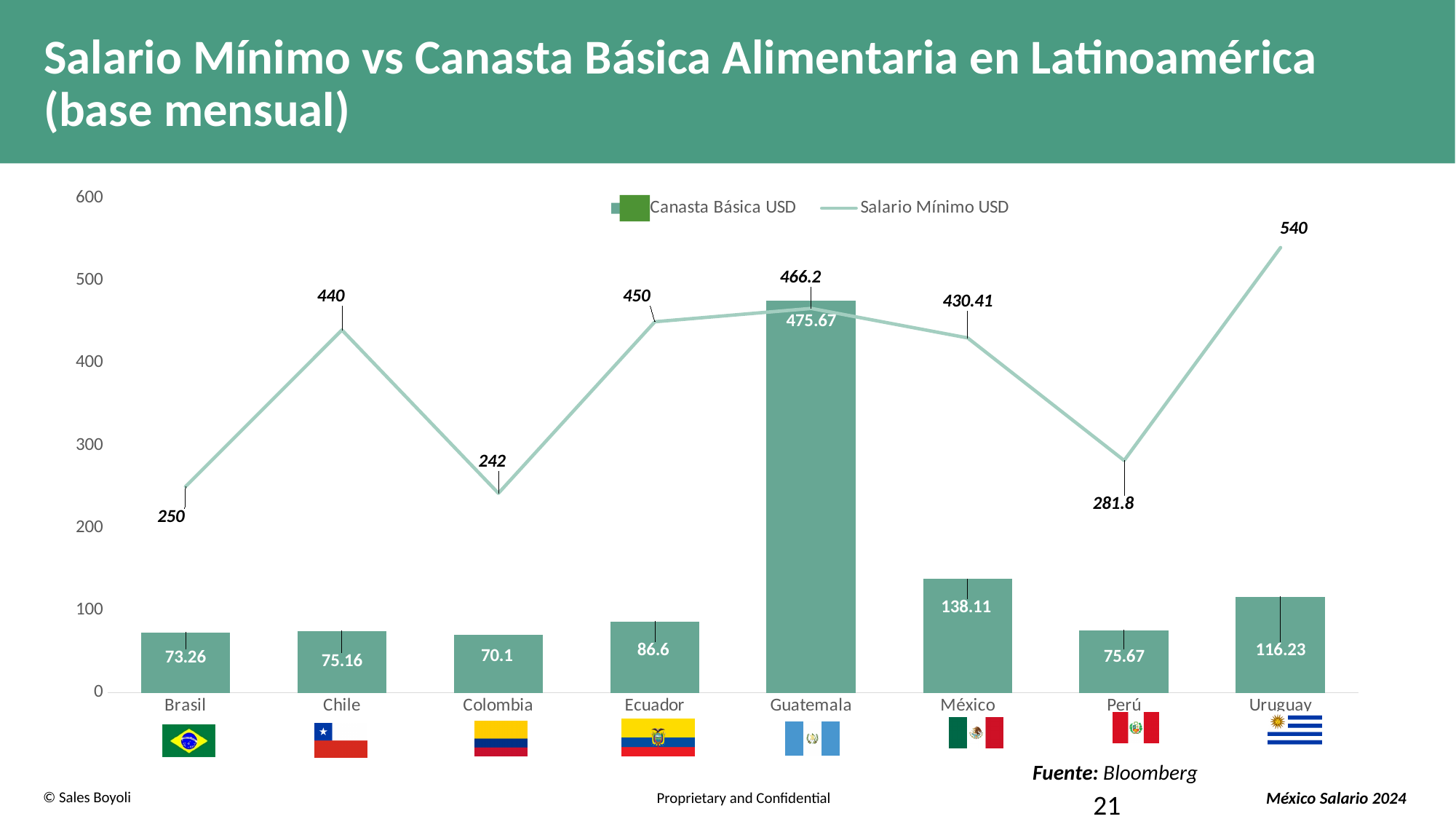
Which country has the highest Salario Mínimo USD? Uruguay What kind of chart is this? Combined bar and line chart Is the Salario Mínimo USD for Perú greater or less than 300? less How many series does the legend list? 2 How many countries are shown on the x axis? 8 What is the difference between the Salario Mínimo USD for Chile and for Brasil? 190 What is the Canasta Básica USD value for México? 138.11 What is the Salario Mínimo USD value for Uruguay? 540 Which country has the lowest Salario Mínimo USD? Colombia Which country has the lowest Canasta Básica USD? Colombia What is the Canasta Básica USD value for Guatemala? 475.67 Which is larger, the Canasta Básica USD for Uruguay or for México? México